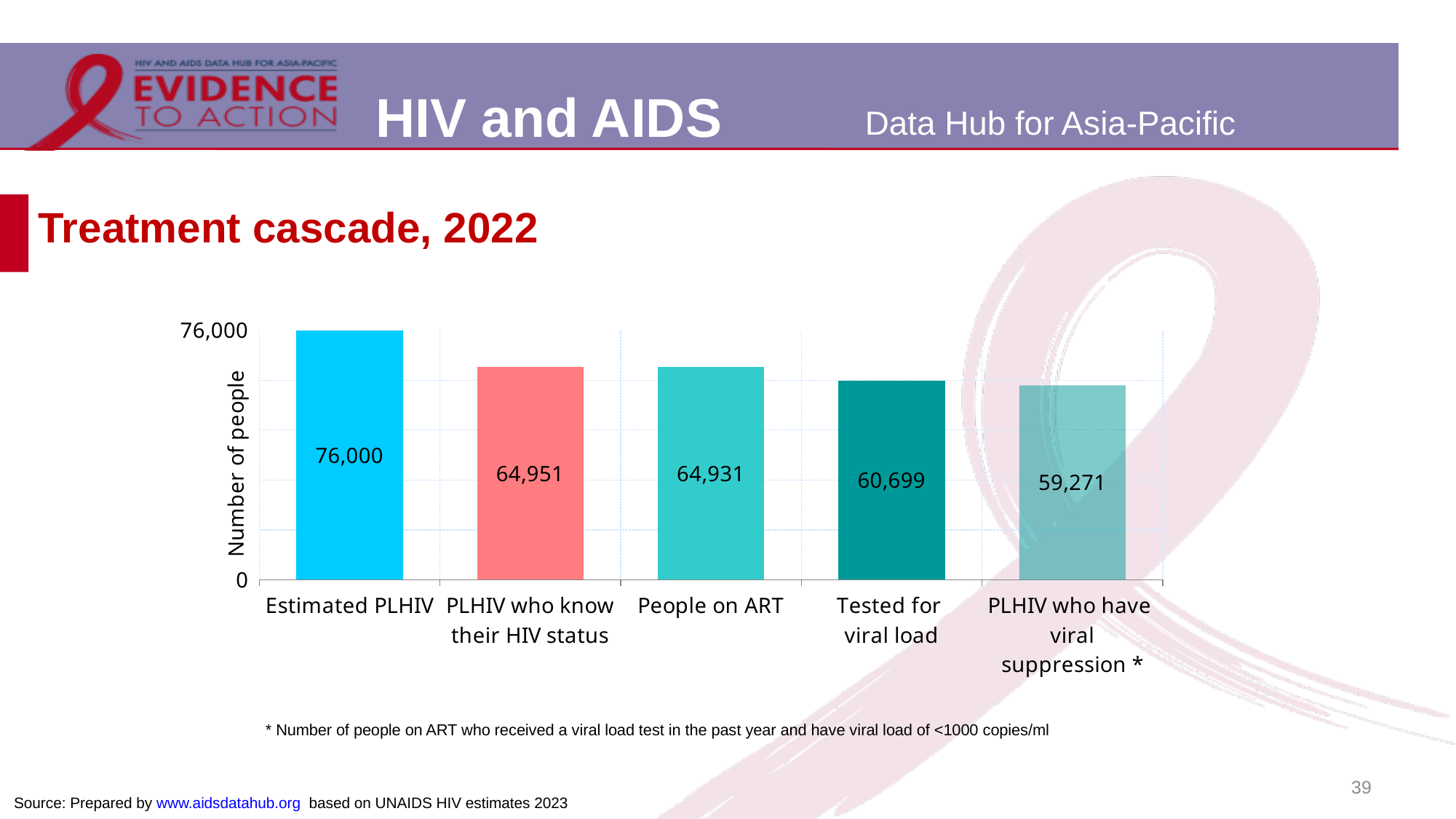
What is the difference between Estimated PLHIV and PLHIV who have viral suppression? 16,729 What is the value for People on ART? 64,931 What is the value for PLHIV who know their HIV status? 64,951 How many categories are shown on the x axis? 5 What is the value for PLHIV who have viral suppression? 59,271 Which is larger, the value for Tested for viral load or the value for PLHIV who have viral suppression? Tested for viral load What is the value for Estimated PLHIV? 76,000 What is the value for Tested for viral load? 60,699 What is the difference between People on ART and Tested for viral load? 4,232 Which category has the highest value? Estimated PLHIV Which category has the lowest value? PLHIV who have viral suppression What kind of chart is shown on the slide? Bar chart